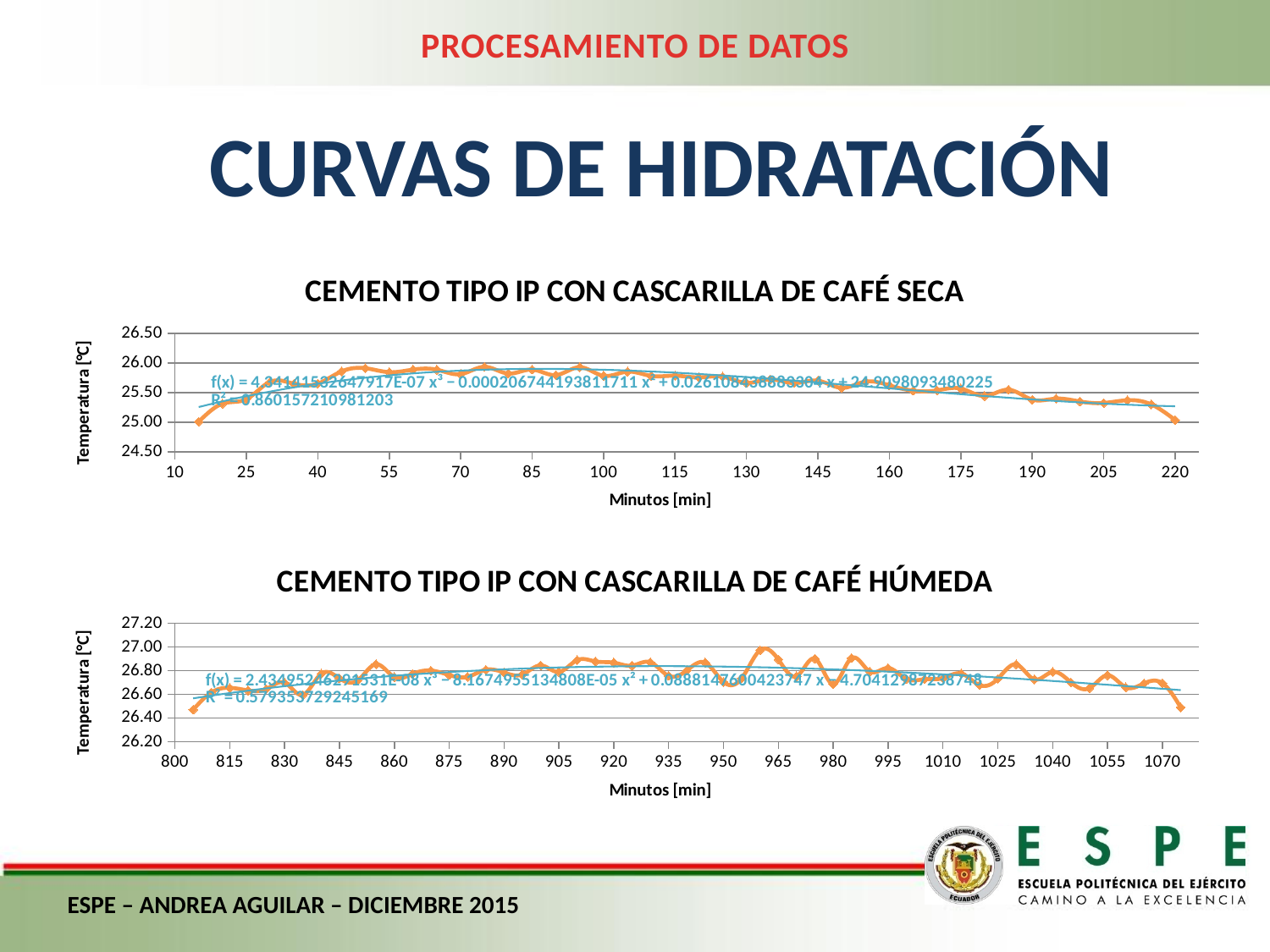
In the top chart 'CEMENTO TIPO IP CON CASCARILLA DE CAFÉ SECA', does the temperature rise or fall between 190 and 220 minutes? fall What is the y-axis title of the top chart 'CEMENTO TIPO IP CON CASCARILLA DE CAFÉ SECA'? Temperatura [°C] In the top chart 'CEMENTO TIPO IP CON CASCARILLA DE CAFÉ SECA', does the temperature rise or fall between 10 and 40 minutes? rise In the top chart 'CEMENTO TIPO IP CON CASCARILLA DE CAFÉ SECA', is the temperature at 55 minutes greater or less than 25.50? greater What kind of chart is the top chart, 'CEMENTO TIPO IP CON CASCARILLA DE CAFÉ SECA'? line chart In the bottom chart 'CEMENTO TIPO IP CON CASCARILLA DE CAFÉ HÚMEDA', is the temperature at the last point (around 1075 minutes) greater or less than 26.60? less In the top chart 'CEMENTO TIPO IP CON CASCARILLA DE CAFÉ SECA', is the temperature at 220 minutes greater or less than 25.50? less What is the x-axis title of the bottom chart 'CEMENTO TIPO IP CON CASCARILLA DE CAFÉ HÚMEDA'? Minutos [min] What kind of chart is the bottom chart, 'CEMENTO TIPO IP CON CASCARILLA DE CAFÉ HÚMEDA'? line chart